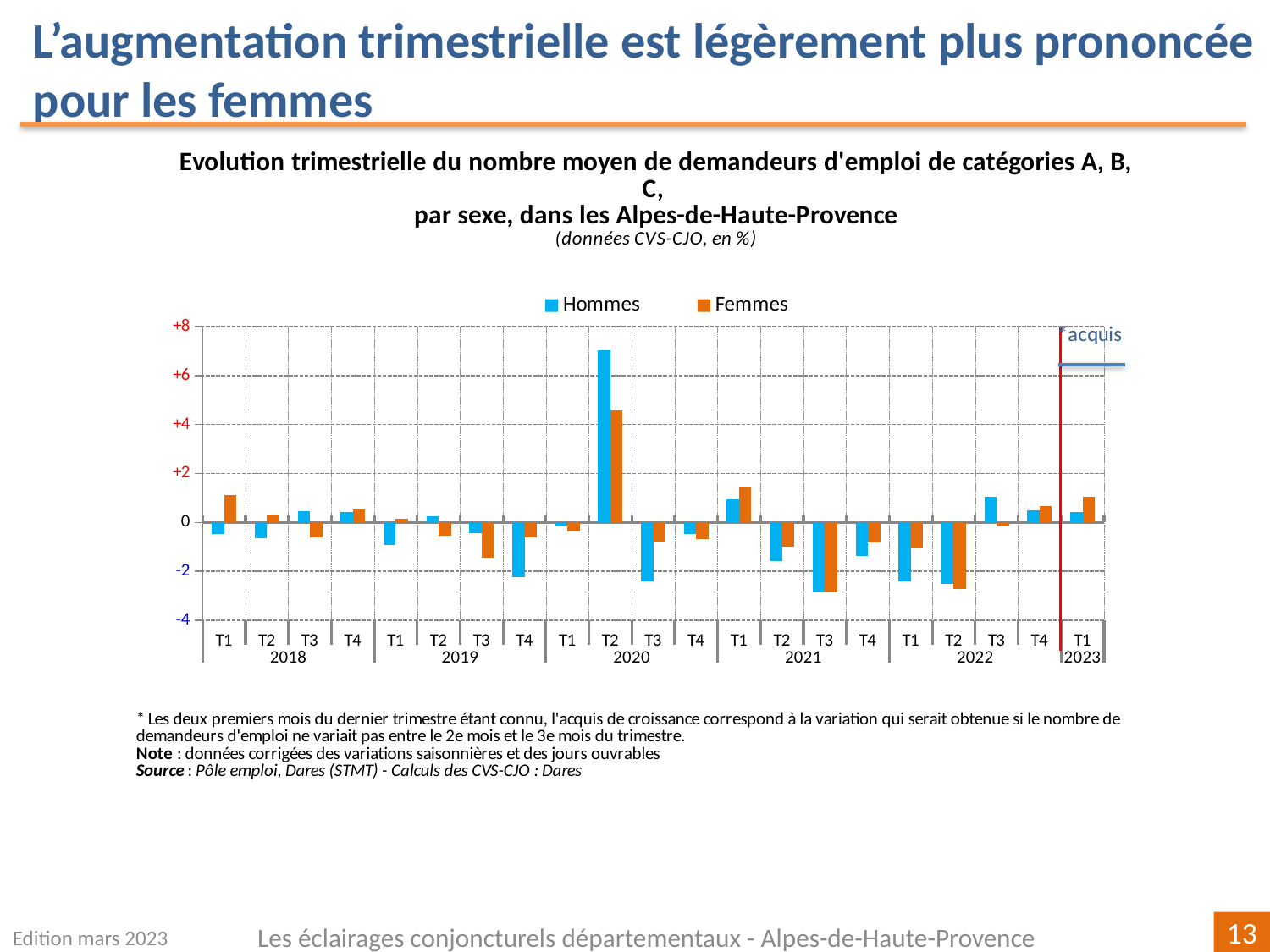
In which quarter is the value for Femmes highest? T2 2020 In which quarter is the value for Hommes highest? T2 2020 What kind of chart is shown on the slide? bar chart In T1 2018, which series has the larger value, Hommes or Femmes? Femmes Is the value for Hommes in T4 2019 greater or less than -2? less Is the value for Femmes in T2 2020 greater or less than +4? greater In T2 2020, which series has the larger value, Hommes or Femmes? Hommes What are the two series named in the legend? Hommes and Femmes How many series does the legend list? 2 Which colour represents the Hommes series? blue How many quarters are plotted along the x axis? 21 Is the value for Hommes in T2 2020 greater or less than +6? greater